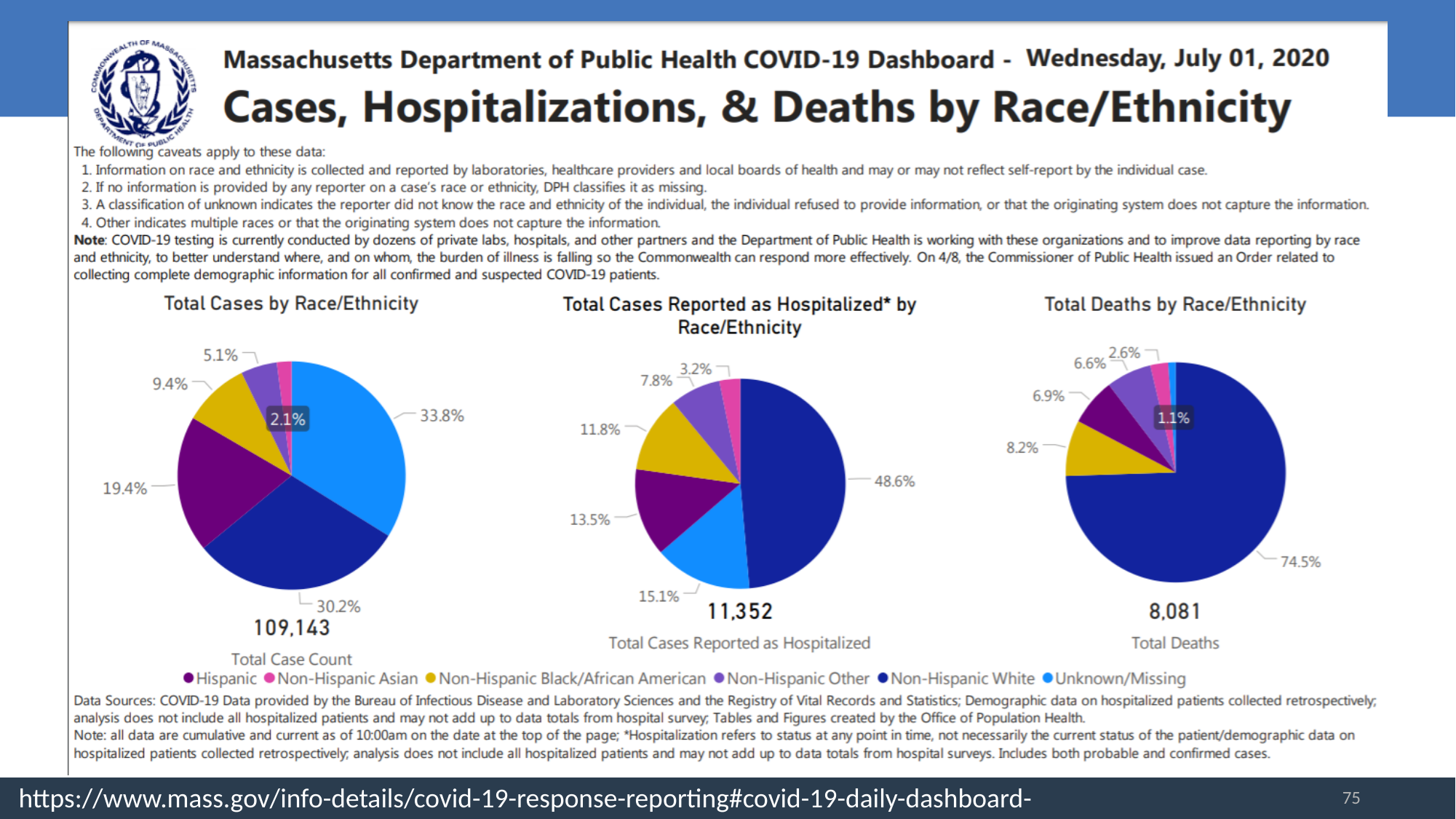
In the Total Cases Reported as Hospitalized by Race/Ethnicity chart, what is the difference in percentage points between the Hispanic share and the Non-Hispanic Black/African American share? 1.7 In the Total Cases Reported as Hospitalized by Race/Ethnicity chart, what share is Non-Hispanic White? 48.6% In the Total Cases by Race/Ethnicity chart, what share of cases is Unknown/Missing? 33.8% What is the Total Deaths figure shown under the Total Deaths by Race/Ethnicity chart? 8,081 In the Total Cases by Race/Ethnicity chart, what share of cases is Hispanic? 19.4% How many race/ethnicity categories does the shared legend list? 6 What is the Total Case Count shown under the Total Cases by Race/Ethnicity chart? 109,143 In the Total Deaths by Race/Ethnicity chart, which is larger: the Non-Hispanic Black/African American share or the Hispanic share? Non-Hispanic Black/African American In the Total Deaths by Race/Ethnicity chart, which race/ethnicity has the smallest share? Unknown/Missing In the Total Deaths by Race/Ethnicity chart, what share of deaths is Non-Hispanic White? 74.5% In the Total Cases by Race/Ethnicity chart, which race/ethnicity has the largest share? Unknown/Missing What kind of chart is the Total Cases Reported as Hospitalized by Race/Ethnicity chart? Pie chart